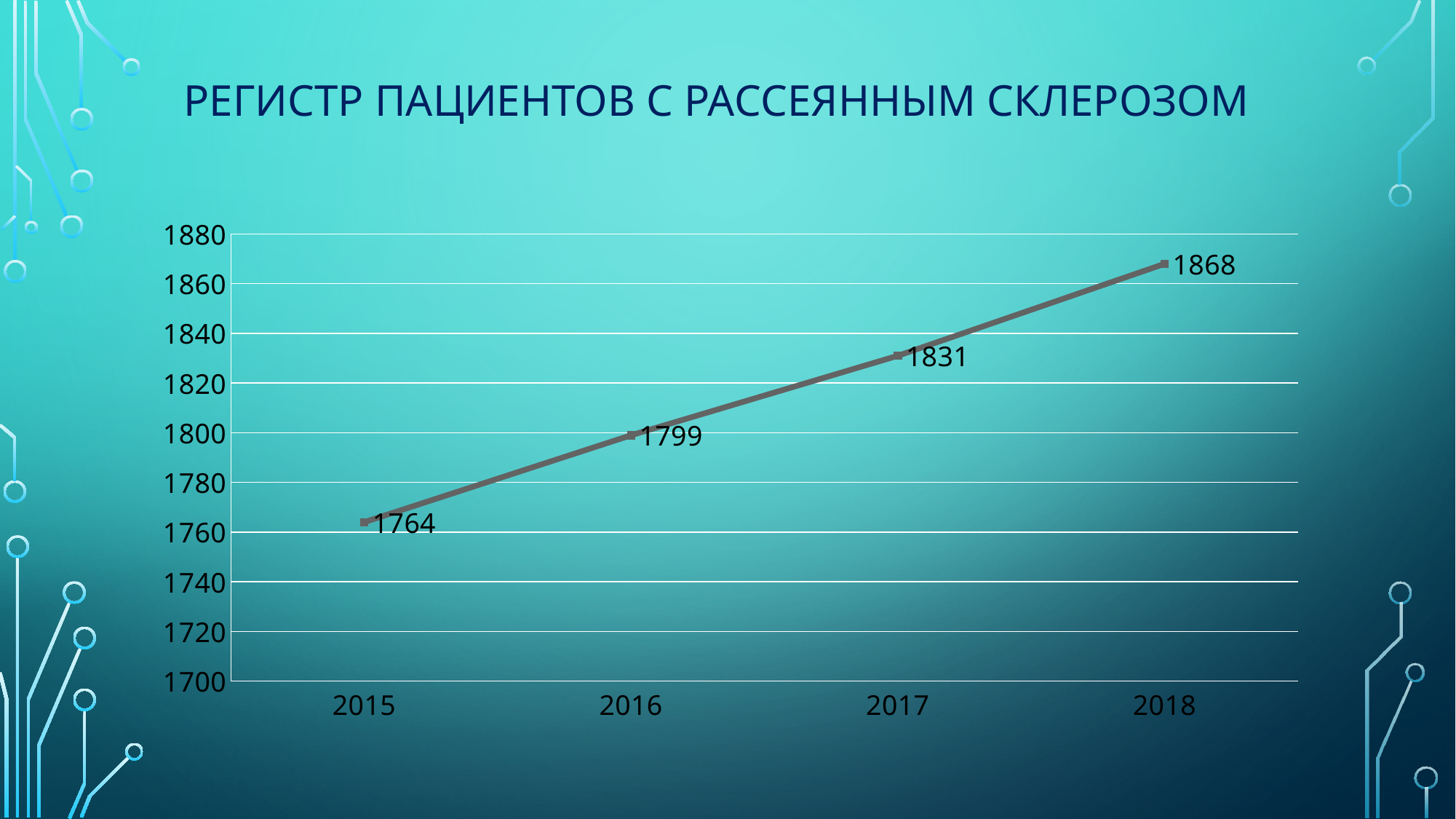
How many data points are plotted on the chart? 4 What is the difference between the values for 2018 and 2015? 104 What kind of chart is shown on the slide? line chart What is the difference between the values for 2017 and 2016? 32 Which is larger, the value for 2016 or the value for 2017? 2017 What is the value for 2017? 1831 Do the values rise or fall from 2015 to 2018? rise What is the value for 2016? 1799 Which year has the lowest value? 2015 What is the value for 2018? 1868 What is the value for 2015? 1764 Which year has the highest value? 2018